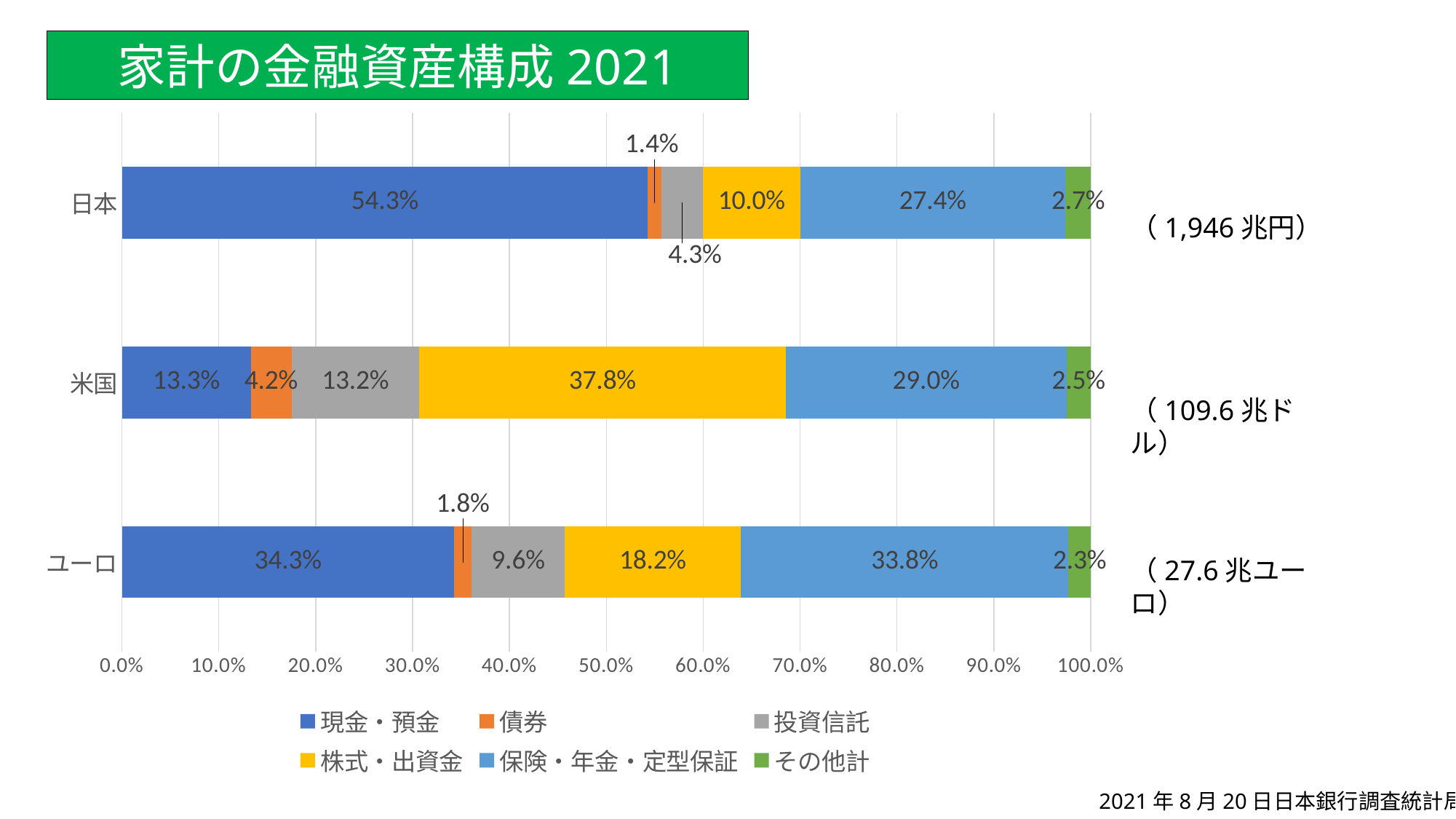
How many series does the legend list? 6 Which region has the lowest 株式・出資金 share? 日本 What type of chart is shown on the slide? Stacked bar chart What is the 債券 share for ユーロ? 1.8% Which is larger, the 投資信託 share for 米国 or for ユーロ? 米国 What is the 現金・預金 share for 日本? 54.3% What is the 株式・出資金 share for 米国? 37.8% What is the title of the chart on the slide? 家計の金融資産構成 2021 Which region has the highest 現金・預金 share? 日本 What is the 保険・年金・定型保証 share for ユーロ? 33.8% What is the difference between the 現金・預金 share of 日本 and that of 米国? 41.0% How many regions (categories) are shown in the chart? 3